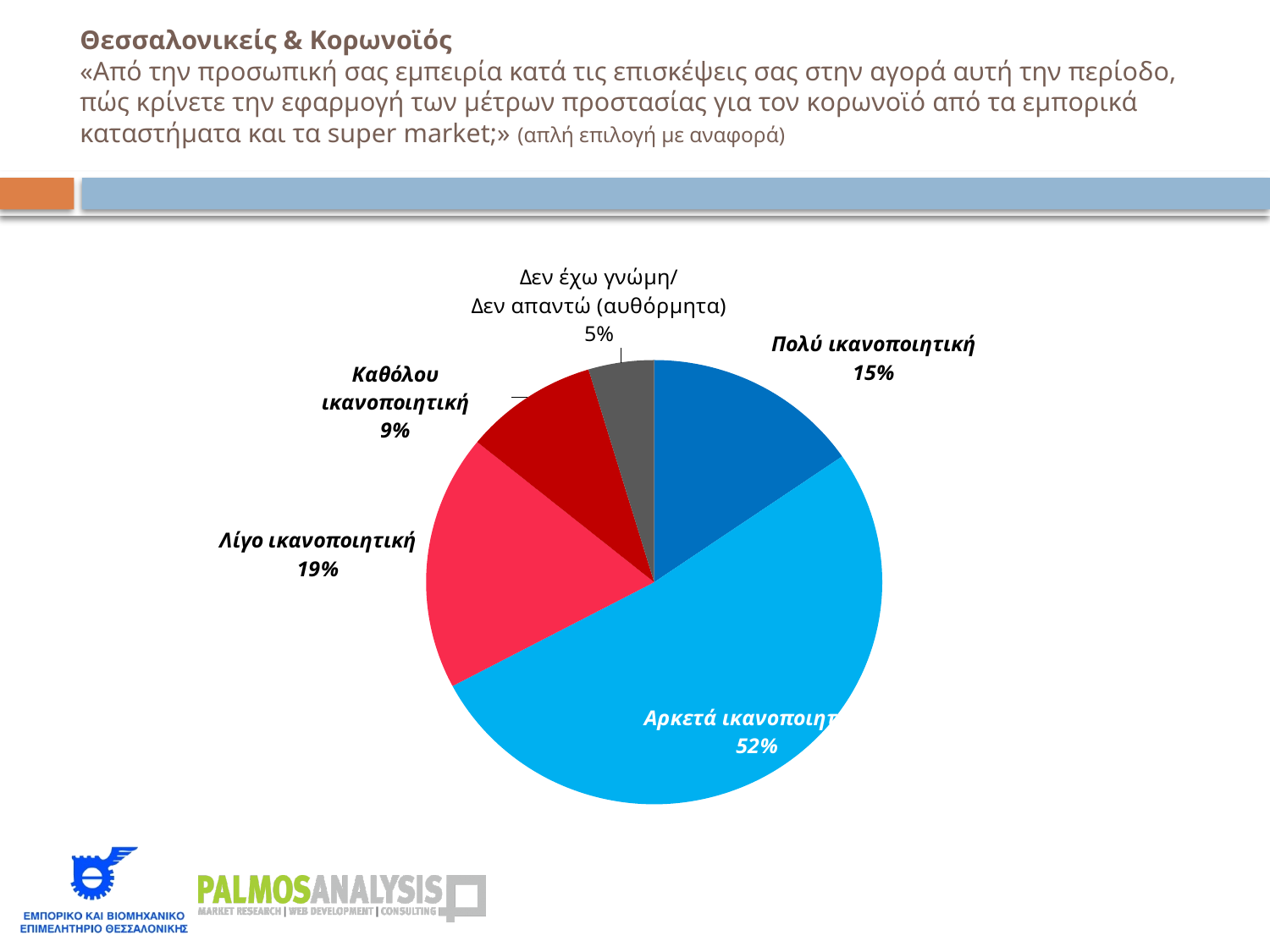
What share of respondents answered "Καθόλου ικανοποιητική"? 9% Which response has the smallest slice of the pie? Δεν έχω γνώμη/Δεν απαντώ (αυθόρμητα) What share of respondents answered "Πολύ ικανοποιητική"? 15% What kind of chart is shown on the slide? pie chart What share of respondents answered "Αρκετά ικανοποιητική"? 52% What share of respondents answered "Λίγο ικανοποιητική"? 19% What share of respondents answered "Δεν έχω γνώμη/Δεν απαντώ (αυθόρμητα)"? 5% What colour is the slice for "Αρκετά ικανοποιητική"? light blue What is the difference in percentage points between "Λίγο ικανοποιητική" and "Πολύ ικανοποιητική"? 4 How many slices does the pie chart have? 5 Which is larger, the share for "Καθόλου ικανοποιητική" or the share for "Πολύ ικανοποιητική"? Πολύ ικανοποιητική Which response has the largest slice of the pie? Αρκετά ικανοποιητική